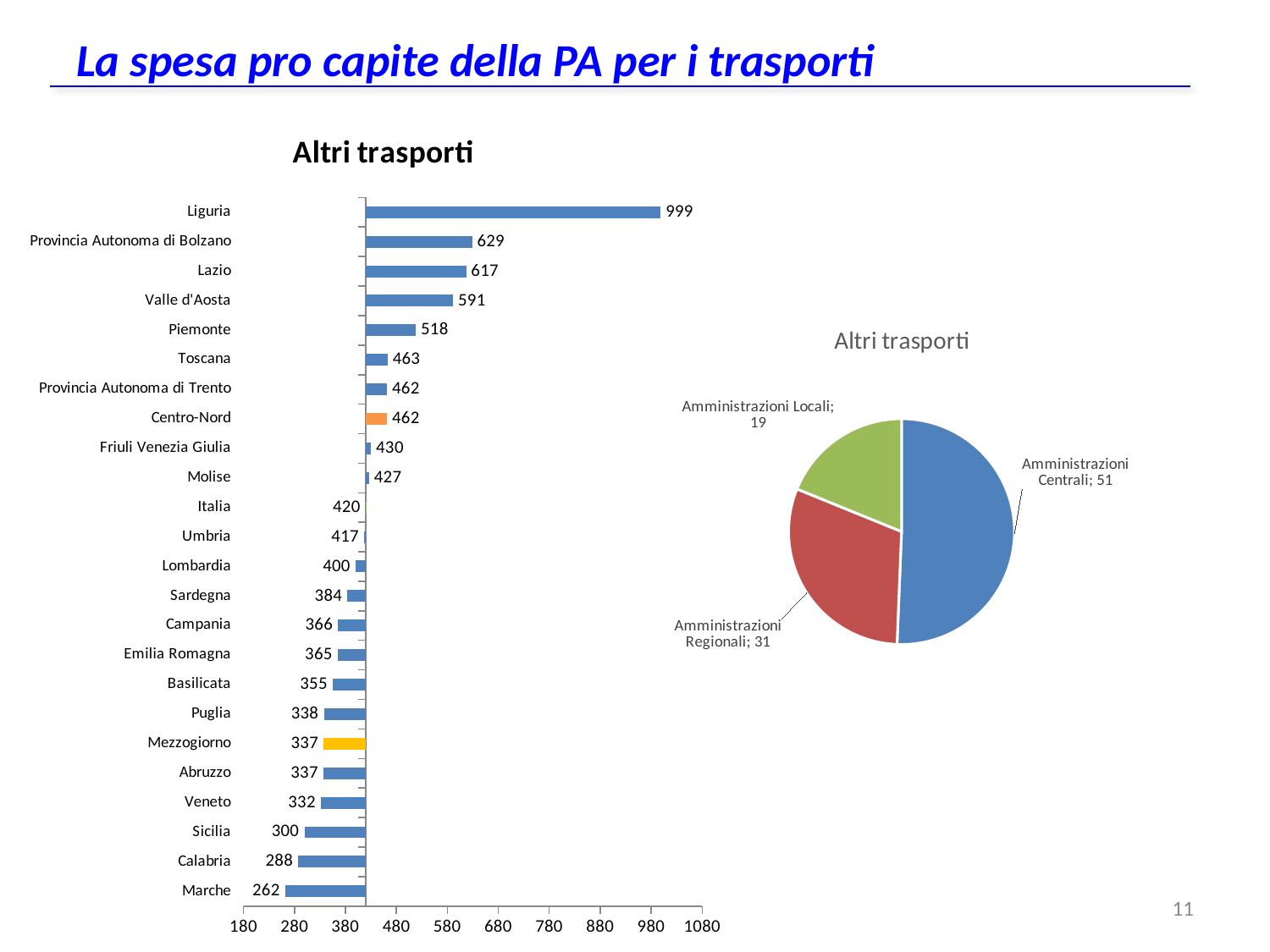
On the bar chart on the left, what is the difference between the values for Liguria and Provincia Autonoma di Bolzano? 370 On the bar chart on the left, which category has the highest value? Liguria What kind of chart is the chart on the right of the slide? Pie chart How many categories are shown on the bar chart on the left? 24 On the bar chart on the left, what is the value for Marche? 262 On the bar chart on the left, which category has the lowest value? Marche What kind of chart is the chart on the left of the slide? Bar chart On the bar chart on the left, which is larger, the value for Lazio or the value for Valle d'Aosta? Lazio On the bar chart on the left, what is the value for Liguria? 999 On the pie chart on the right, what is the value for Amministrazioni Centrali? 51 On the pie chart on the right, which slice is the smallest? Amministrazioni Locali On the bar chart on the left, what is the value for Italia? 420